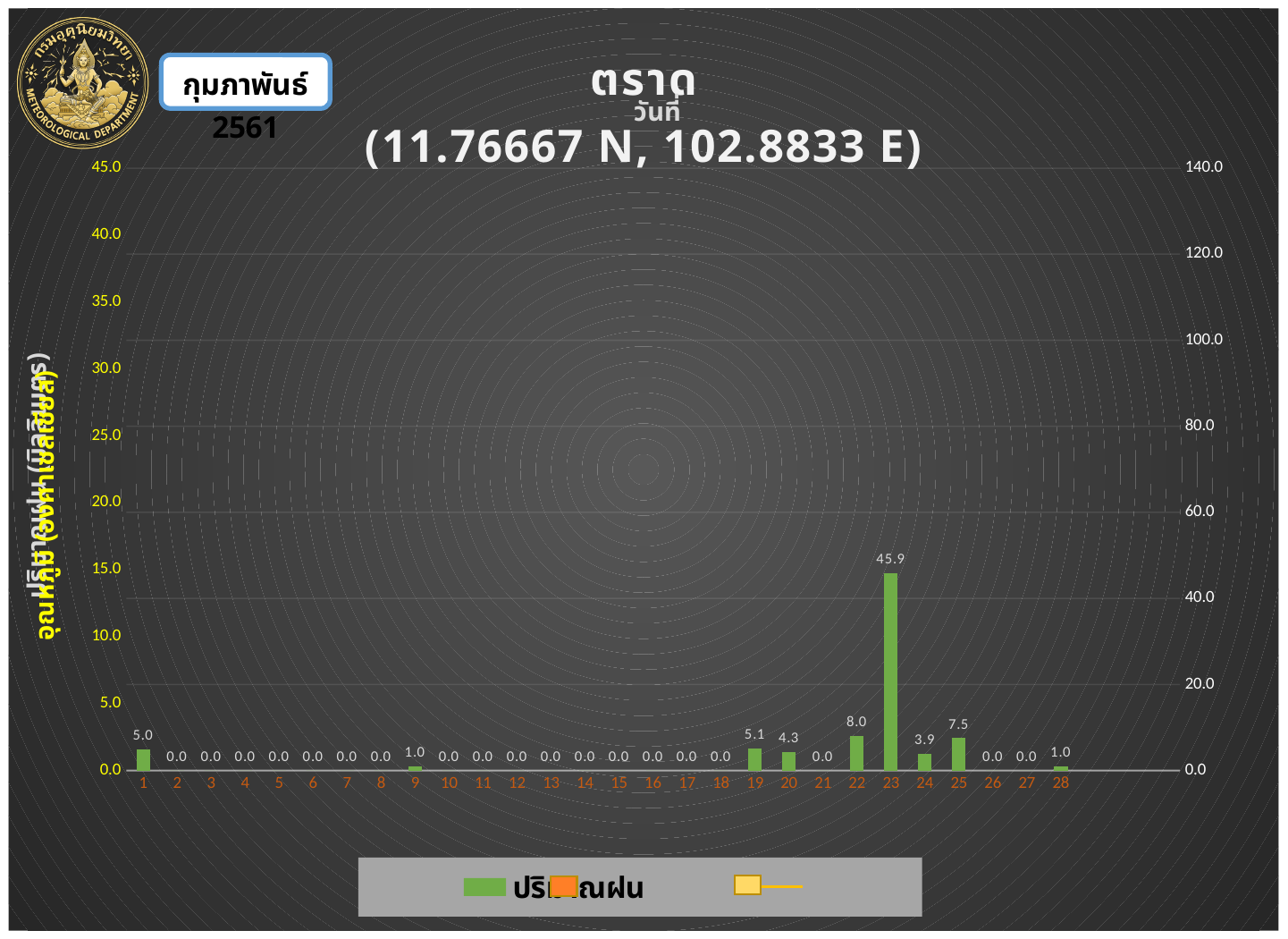
How many days are shown on the x axis? 28 What is the value for day 23? 45.9 What is the value for day 22? 8.0 What is the difference between the values for day 23 and day 22? 37.9 Which is larger, the value for day 19 or the value for day 20? day 19 What is the value for day 25? 7.5 What is the value for day 1? 5.0 What is the value for day 20? 4.3 Which day has the highest value? 23 What is the difference between the values for day 25 and day 24? 3.6 What kind of chart is this? bar chart What are the coordinates shown in the chart title? (11.76667 N, 102.8833 E)